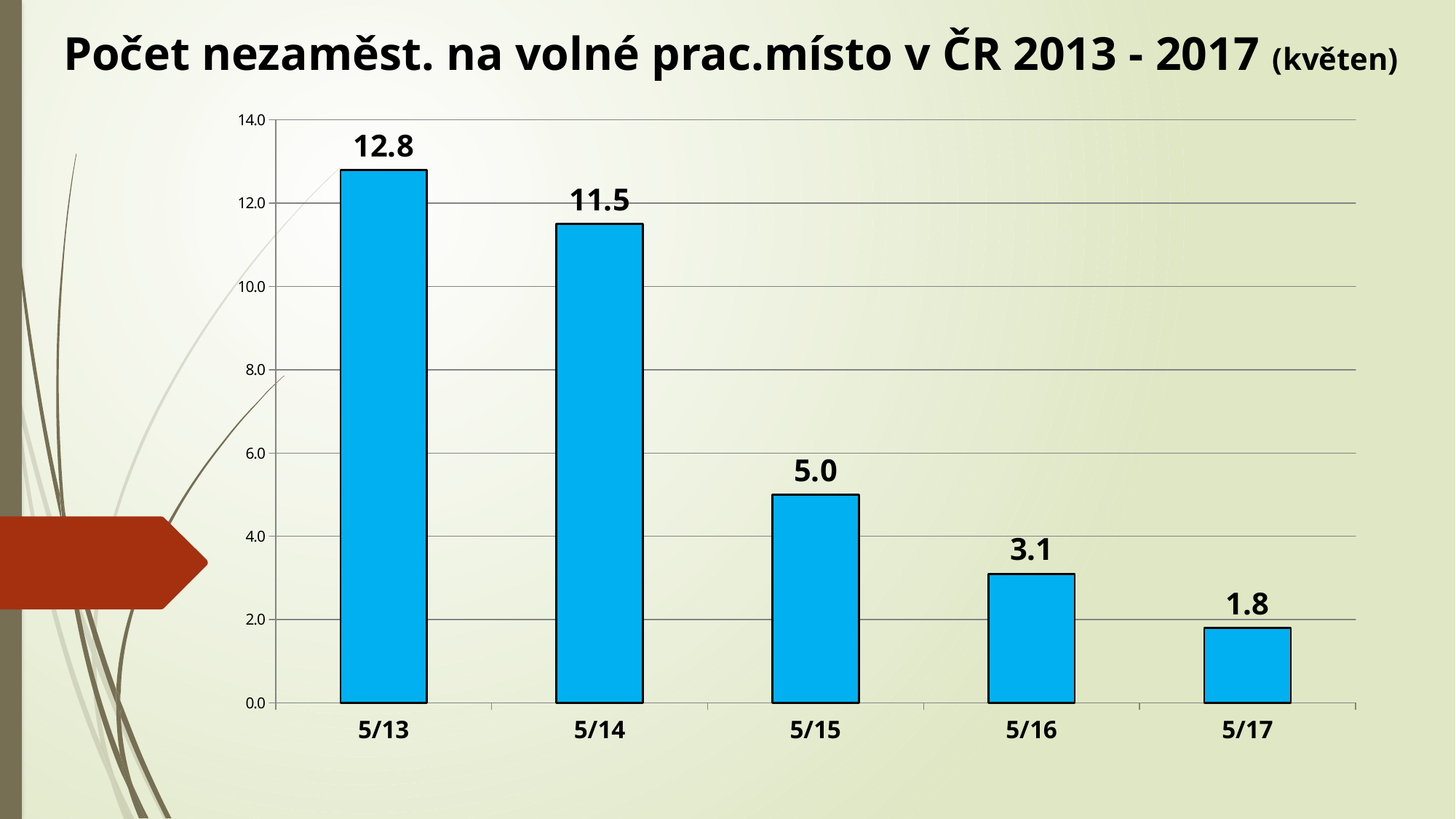
Which is larger, the value for 5/16 or the value for 5/17? 5/16 Is the value for 5/14 greater or less than 10.0? greater Do the values rise or fall from 5/13 to 5/17? fall How many categories are shown on the x axis? 5 What is the value for 5/17? 1.8 What is the value for 5/15? 5.0 What kind of chart is shown on the slide? bar chart What is the value for 5/13? 12.8 What is the difference between the values for 5/15 and 5/16? 1.9 Which category has the highest value? 5/13 Which category has the lowest value? 5/17 What is the difference between the values for 5/13 and 5/14? 1.3